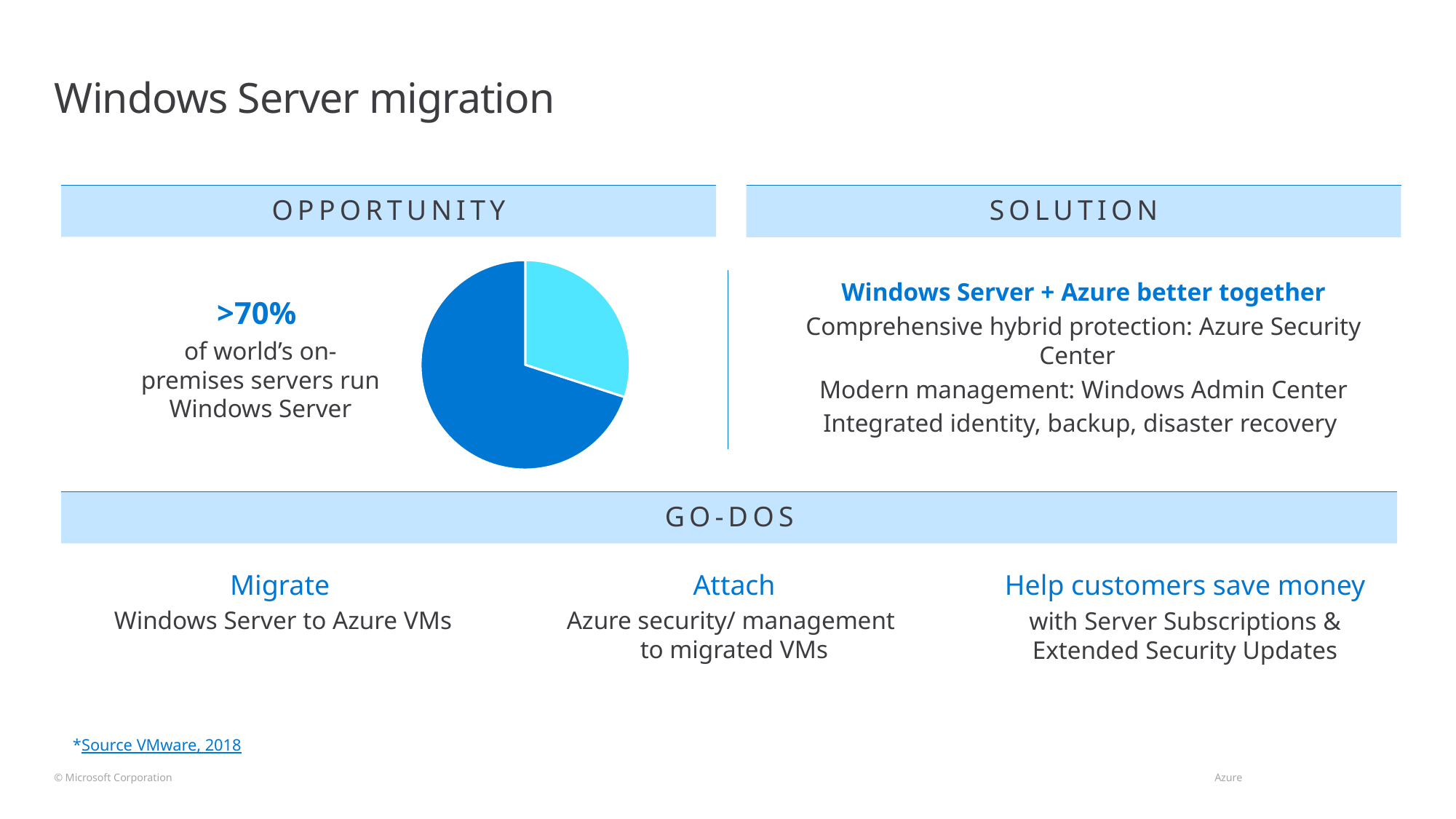
Which slice of the pie chart is the smallest? the light blue slice Does the light blue slice of the pie chart represent more or less than half of the pie? less Which slice of the pie chart is larger, the dark blue slice or the light blue slice? dark blue What kind of chart is shown in the Opportunity section of the slide? pie chart How many slices does the pie chart have? 2 Does the dark blue slice of the pie chart represent more or less than half of the pie? more Which slice of the pie chart is the largest? the dark blue slice What source is cited for the pie chart statistic on the slide? Source VMware, 2018 According to the text next to the pie chart, what share of the world's on-premises servers run Windows Server? >70%